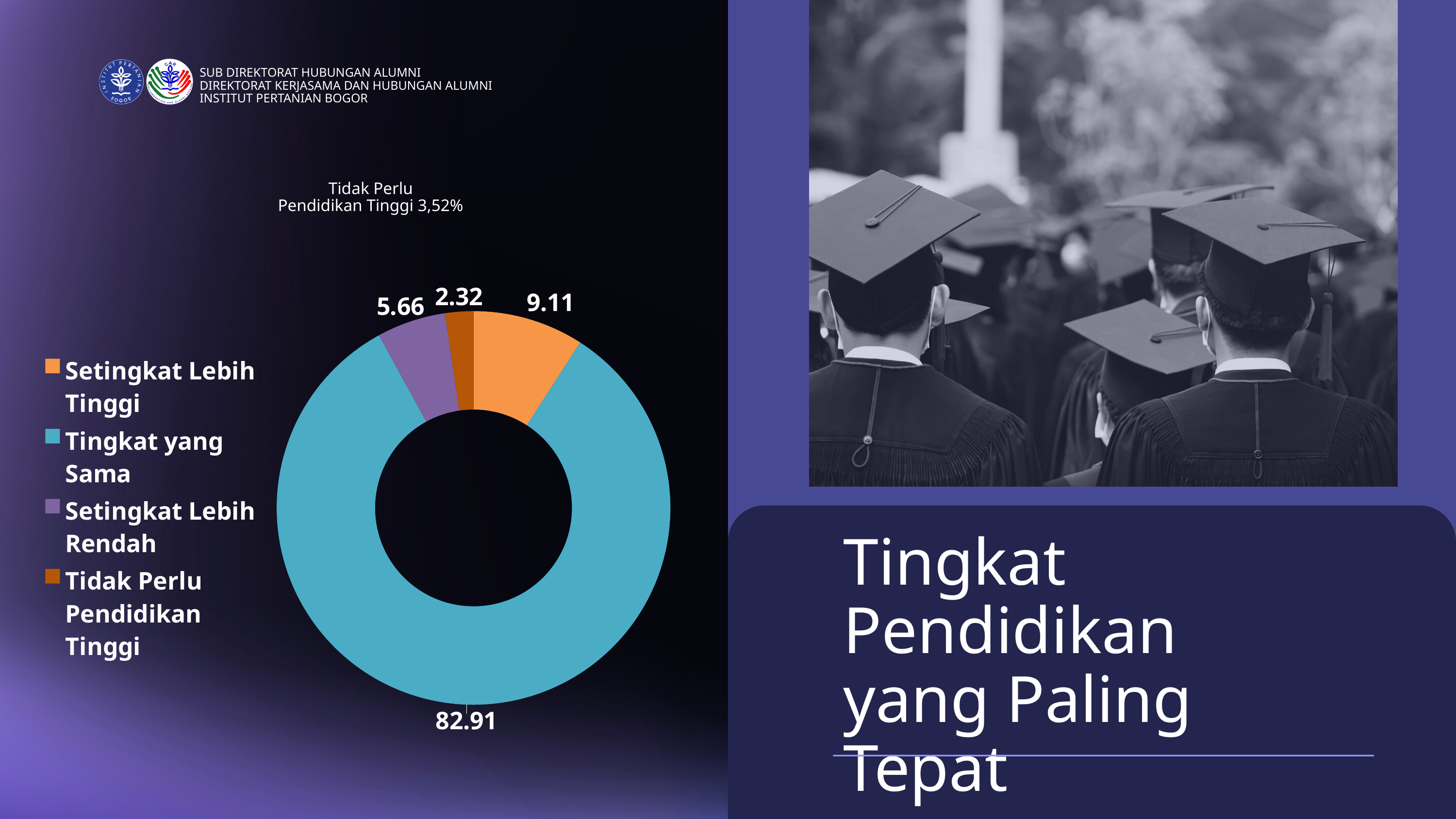
What is the value for Setingkat Lebih Tinggi? 9.11 What colour is the slice for Tingkat yang Sama? Teal (light blue) Which category has the largest share of the doughnut chart? Tingkat yang Sama What is the difference between the values for Tingkat yang Sama and Setingkat Lebih Tinggi? 73.80 What is the value for Tingkat yang Sama? 82.91 What is the difference between the values for Setingkat Lebih Tinggi and Setingkat Lebih Rendah? 3.45 What is the value for Setingkat Lebih Rendah? 5.66 Which legend entry is shown in orange? Setingkat Lebih Tinggi How many categories does the doughnut chart show? 4 What kind of chart is shown on the slide? Doughnut (pie) chart Which is larger, Setingkat Lebih Tinggi or Setingkat Lebih Rendah? Setingkat Lebih Tinggi Which category has the smallest share of the doughnut chart? Tidak Perlu Pendidikan Tinggi